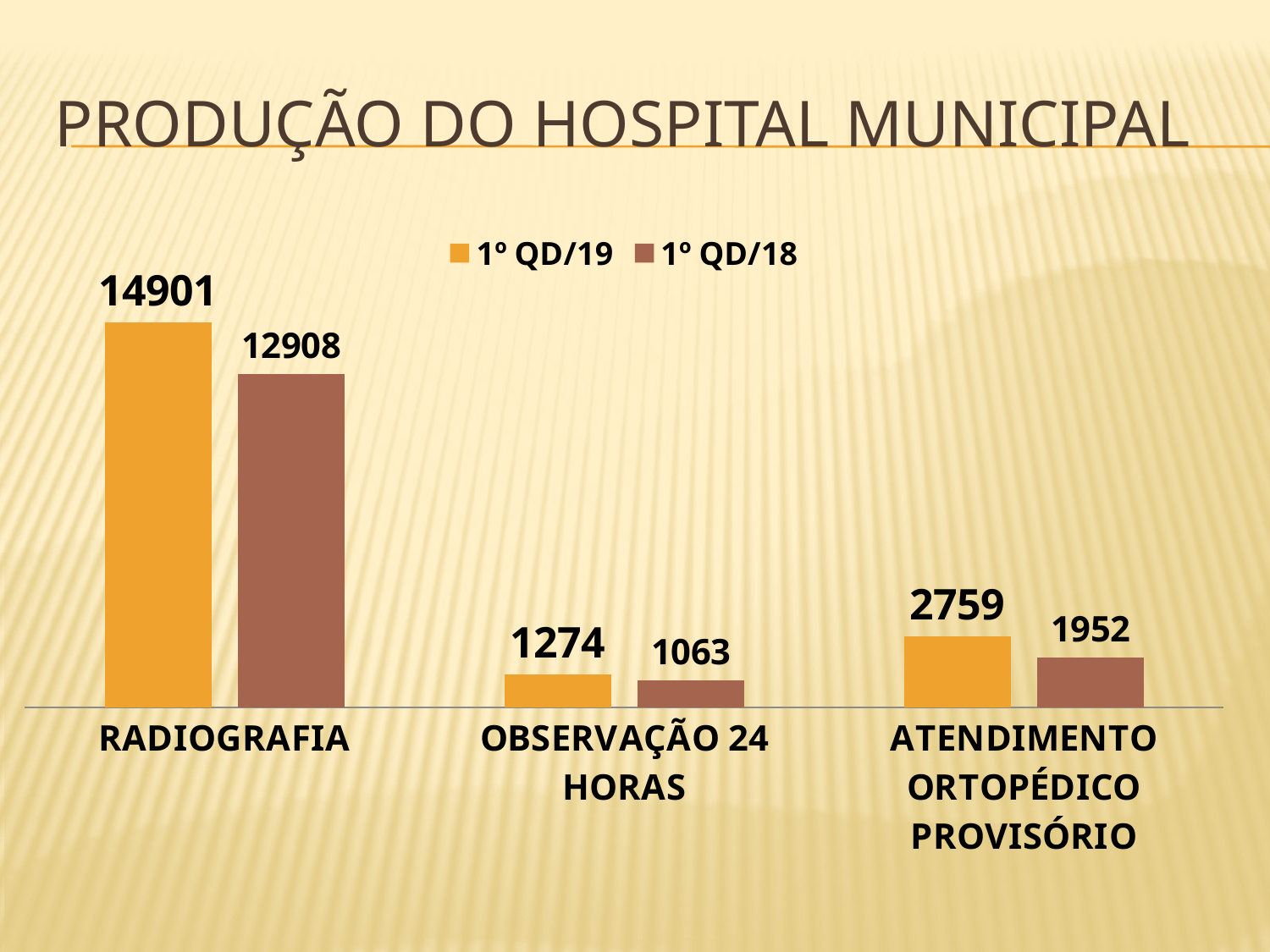
What is the value for RADIOGRAFIA in the 1º QD/18 series? 12908 What is the difference between the 1º QD/19 and 1º QD/18 values for RADIOGRAFIA? 1993 How many series does the legend list? 2 What is the value for RADIOGRAFIA in the 1º QD/19 series? 14901 What is the difference between the 1º QD/19 and 1º QD/18 values for ATENDIMENTO ORTOPÉDICO PROVISÓRIO? 807 Which category has the highest value in the 1º QD/19 series? RADIOGRAFIA What is the value for ATENDIMENTO ORTOPÉDICO PROVISÓRIO in the 1º QD/18 series? 1952 What kind of chart is shown on the slide? Bar chart Which is larger for OBSERVAÇÃO 24 HORAS: the 1º QD/19 value or the 1º QD/18 value? 1º QD/19 Which category has the lowest value in the 1º QD/18 series? OBSERVAÇÃO 24 HORAS What is the value for OBSERVAÇÃO 24 HORAS in the 1º QD/19 series? 1274 How many categories are shown on the x axis? 3